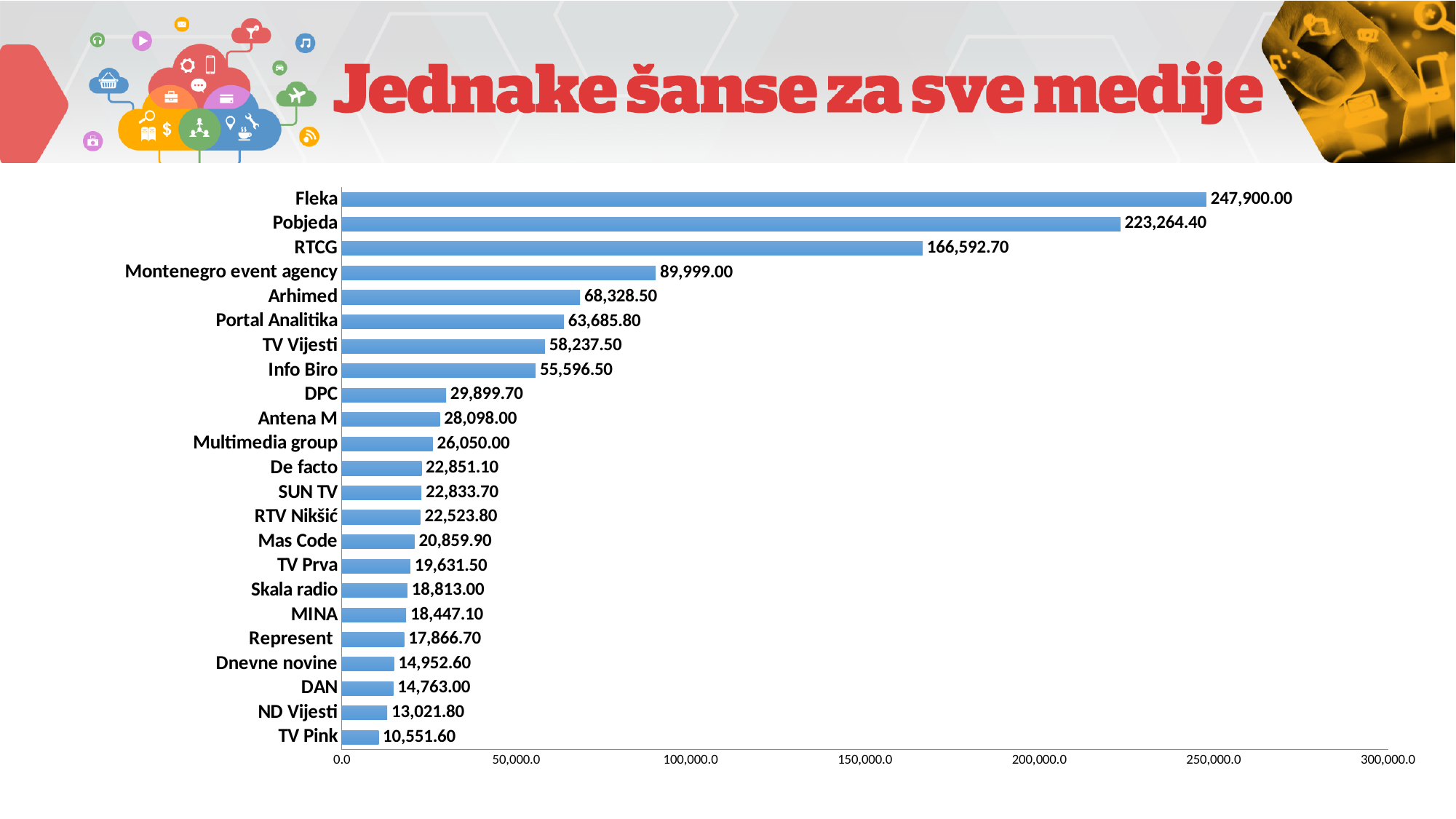
What is the difference between the values for RTCG and Montenegro event agency? 76,593.70 What is the title of the slide? Jednake šanse za sve medije What is the value for RTCG? 166,592.70 Which category has the highest value? Fleka What is the difference between the values for Fleka and Pobjeda? 24,635.60 Which has a larger value, Arhimed or Portal Analitika? Arhimed What is the value for Skala radio? 18,813.00 How many categories are shown in the chart? 23 Which category has the lowest value? TV Pink What kind of chart is shown on the slide? bar chart Is the value for Pobjeda greater or less than 200,000.0? greater What is the value for Montenegro event agency? 89,999.00